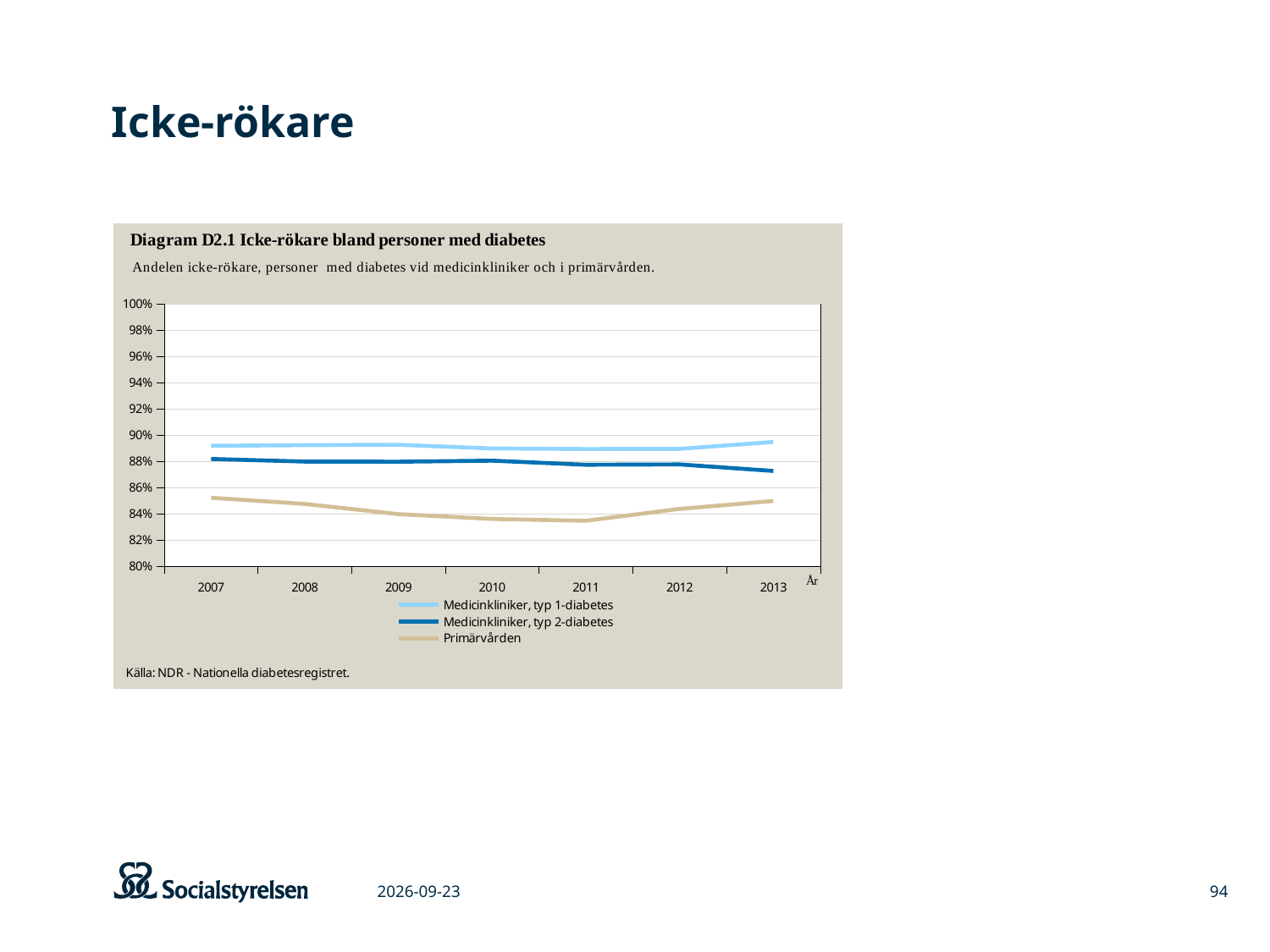
Is the value for Medicinkliniker, typ 1-diabetes in 2013 greater or less than 88%? greater In 2010, which is larger: Medicinkliniker, typ 1-diabetes or Primärvården? Medicinkliniker, typ 1-diabetes Is the value for Primärvården in 2007 greater or less than 84%? greater What kind of chart is shown in Diagram D2.1? Line chart How many years are plotted along the x axis of Diagram D2.1? 7 Is the value for Primärvården in 2011 greater or less than 86%? less What is the source given below the chart? NDR - Nationella diabetesregistret Which series has the lowest values throughout Diagram D2.1? Primärvården How many series does the legend of Diagram D2.1 list? 3 How does the Primärvården line change from 2007 to 2011? It falls Which series has the highest values throughout Diagram D2.1? Medicinkliniker, typ 1-diabetes